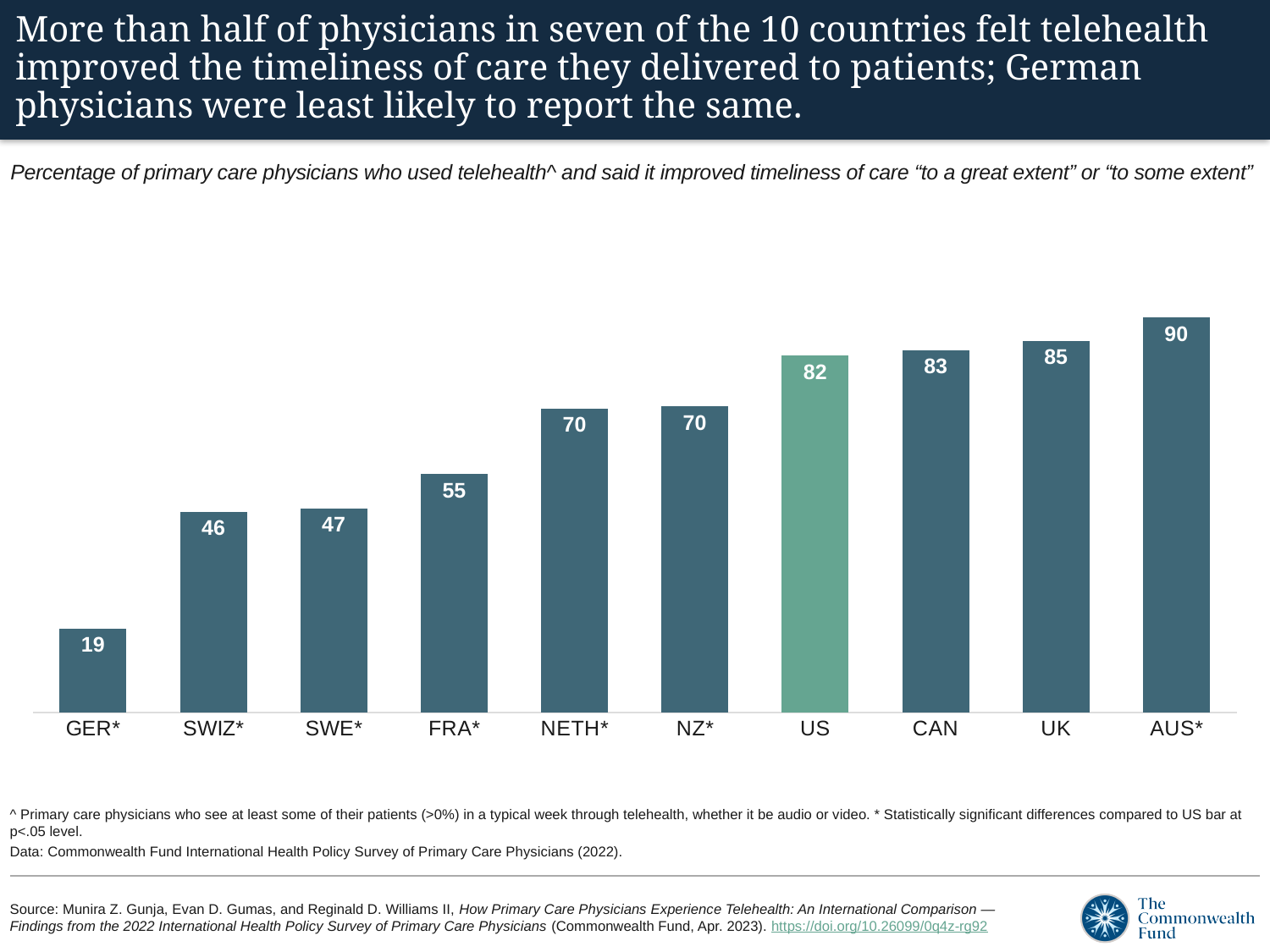
How many countries are shown in the chart? 10 What is the value for the US? 82 Which country has the highest value? AUS* What is the value for GER*? 19 Which country has the lowest value? GER* What kind of chart is shown on the slide? bar chart What is the value for FRA*? 55 What is the difference between the values for AUS* and GER*? 71 Do the values rise or fall from left to right across the countries? rise Which is larger, the value for SWIZ* or the value for SWE*? SWE* What is the difference between the values for UK and CAN? 2 Which bar is shown in a different (green) colour from the others? US